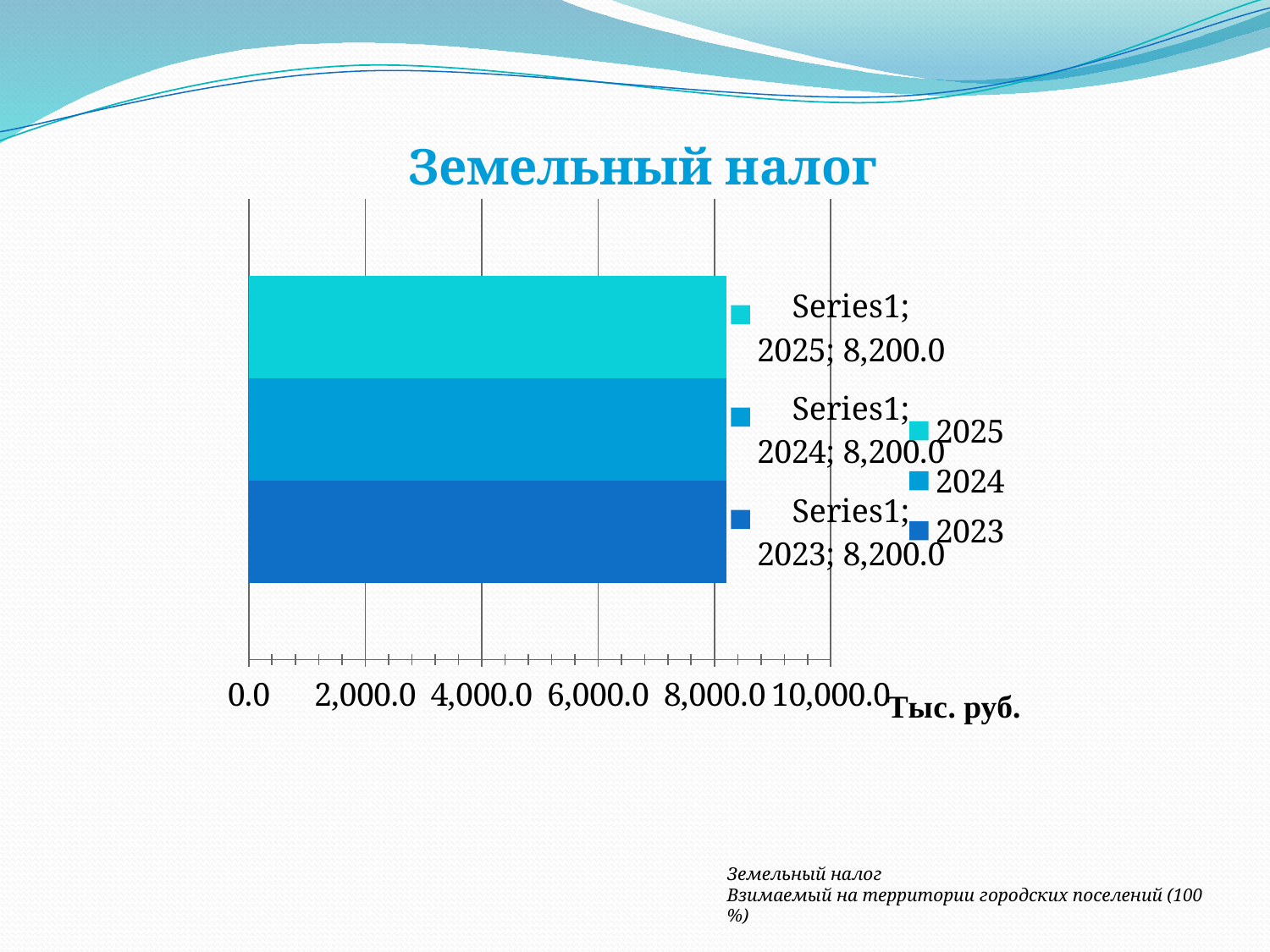
What unit label is shown next to the horizontal axis? Тыс. руб. Do the values rise, fall, or stay the same from 2023 to 2025? stay the same How many entries does the legend list? 3 What is the title of the chart? Земельный налог How many bars are plotted in the chart? 3 What is the difference between the values for 2025 and 2023? 0.0 What type of chart is shown on the slide? bar chart What is the value for 2023? 8,200.0 What is the value for 2025? 8,200.0 Is the value for 2023 greater or less than 10,000.0? less Is the value for 2024 greater or less than 6,000.0? greater What is the value for 2024? 8,200.0